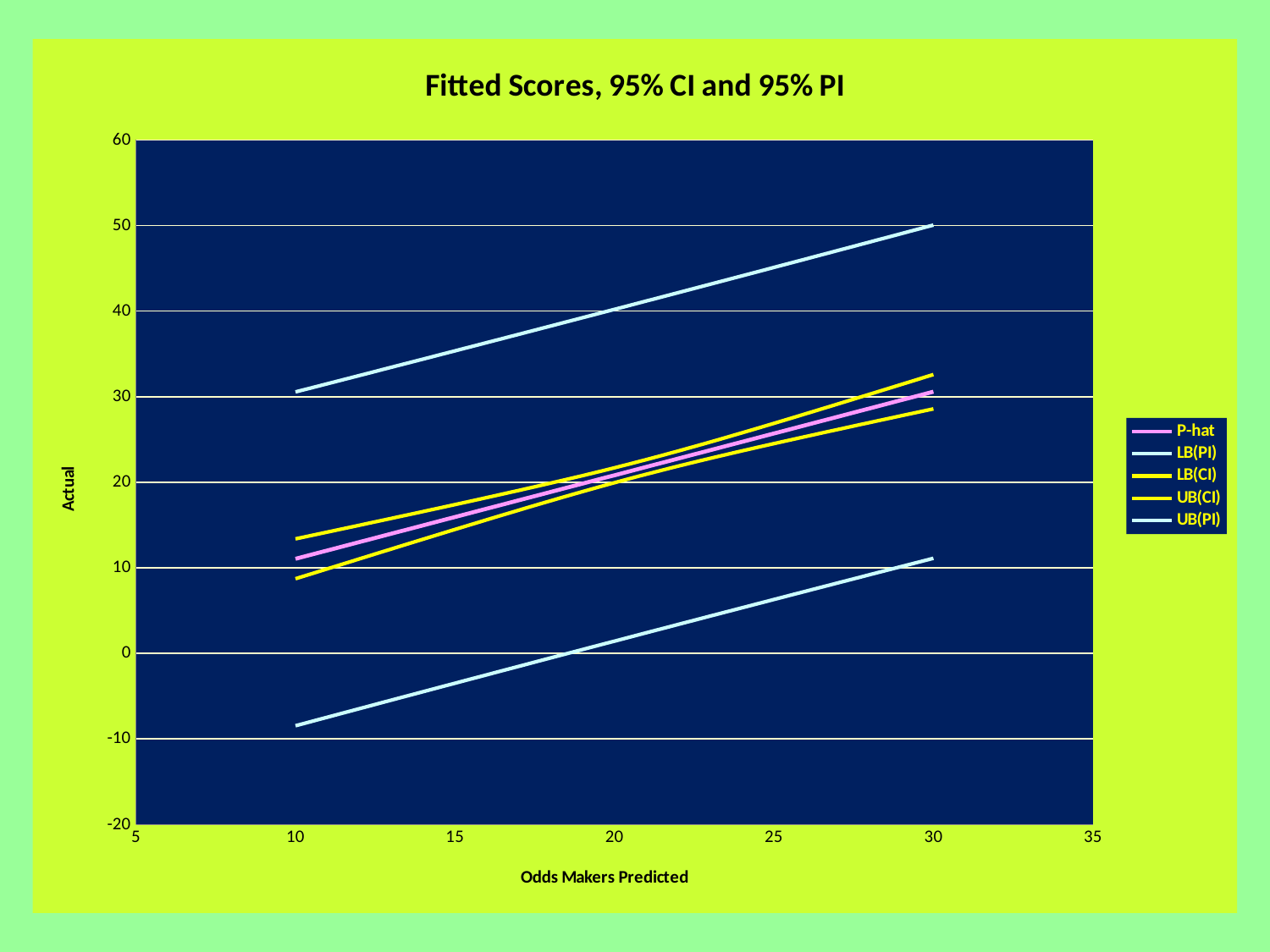
At Odds Makers Predicted = 30, which is larger, UB(PI) or LB(PI)? UB(PI) Is the value of UB(PI) at Odds Makers Predicted = 25 greater or less than 40? greater Is the value of UB(CI) at Odds Makers Predicted = 30 greater or less than 30? greater What is the label of the x axis? Odds Makers Predicted Is the value of LB(CI) at Odds Makers Predicted = 10 greater or less than 10? less Which series lies lowest on the chart across the plotted range? LB(PI) What is the title of the chart? Fitted Scores, 95% CI and 95% PI Do the P-hat values rise or fall as Odds Makers Predicted increases? rise What kind of chart is shown on the slide? line chart Which series lies highest on the chart across the plotted range? UB(PI) How many series does the legend list? 5